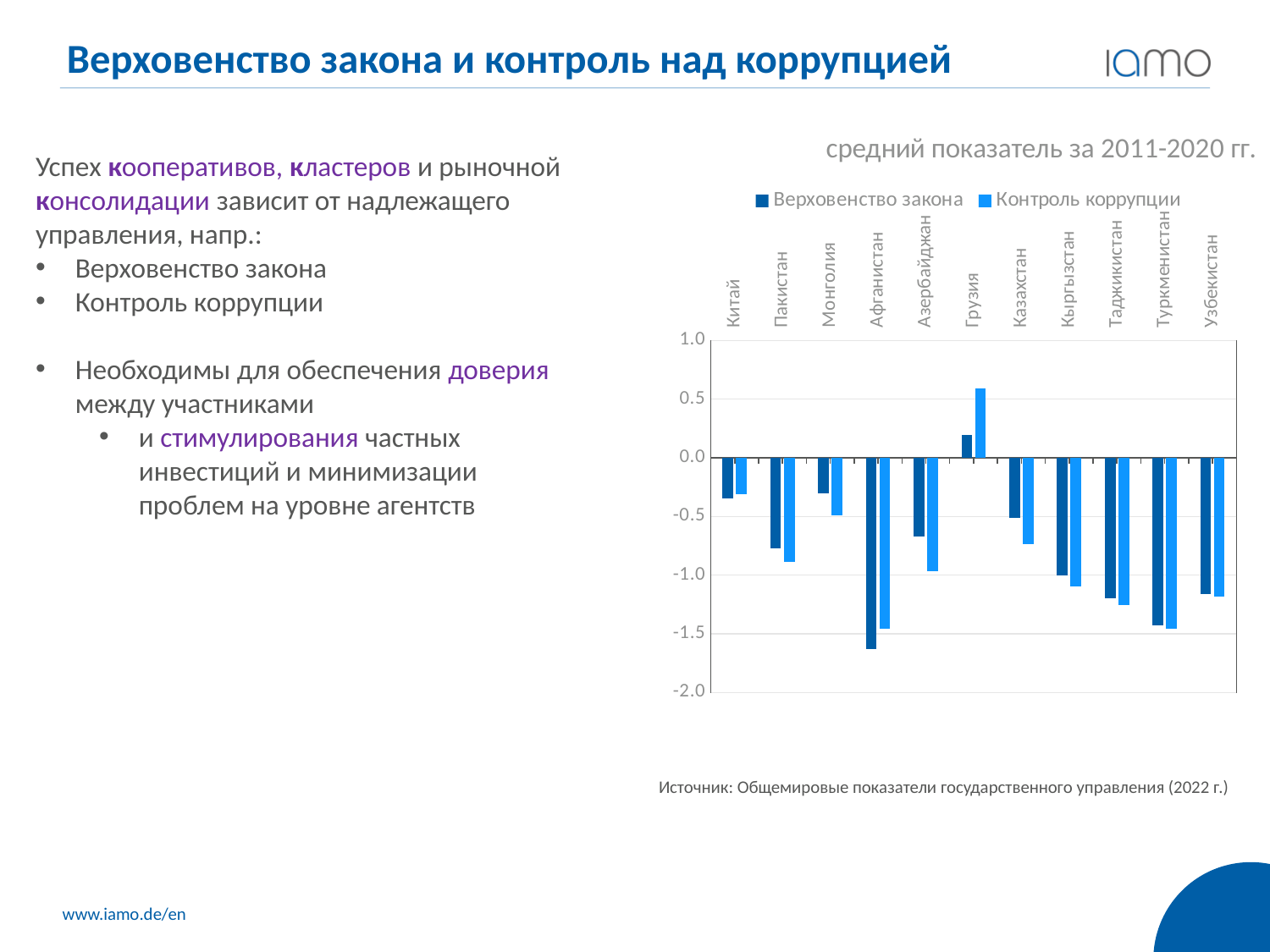
Which country has the highest value for Контроль коррупции? Грузия Is the value for Верховенство закона for Афганистан greater or less than -1.5? less What period does the chart subtitle say the average indicator covers? 2011-2020 гг. What kind of chart is shown on the slide? bar chart Which country has the lowest value for Верховенство закона? Афганистан How many countries are shown on the x axis of the chart? 11 Is the value for Контроль коррупции for Грузия greater or less than 0.5? greater How many series does the chart legend list? 2 Which is larger, the Верховенство закона value for Грузия or for Китай? Грузия Which is larger, the Контроль коррупции value for Монголия or for Азербайджан? Монголия Is the value for Контроль коррупции for Пакистан greater or less than -0.5? less Which country has the highest value for Верховенство закона? Грузия